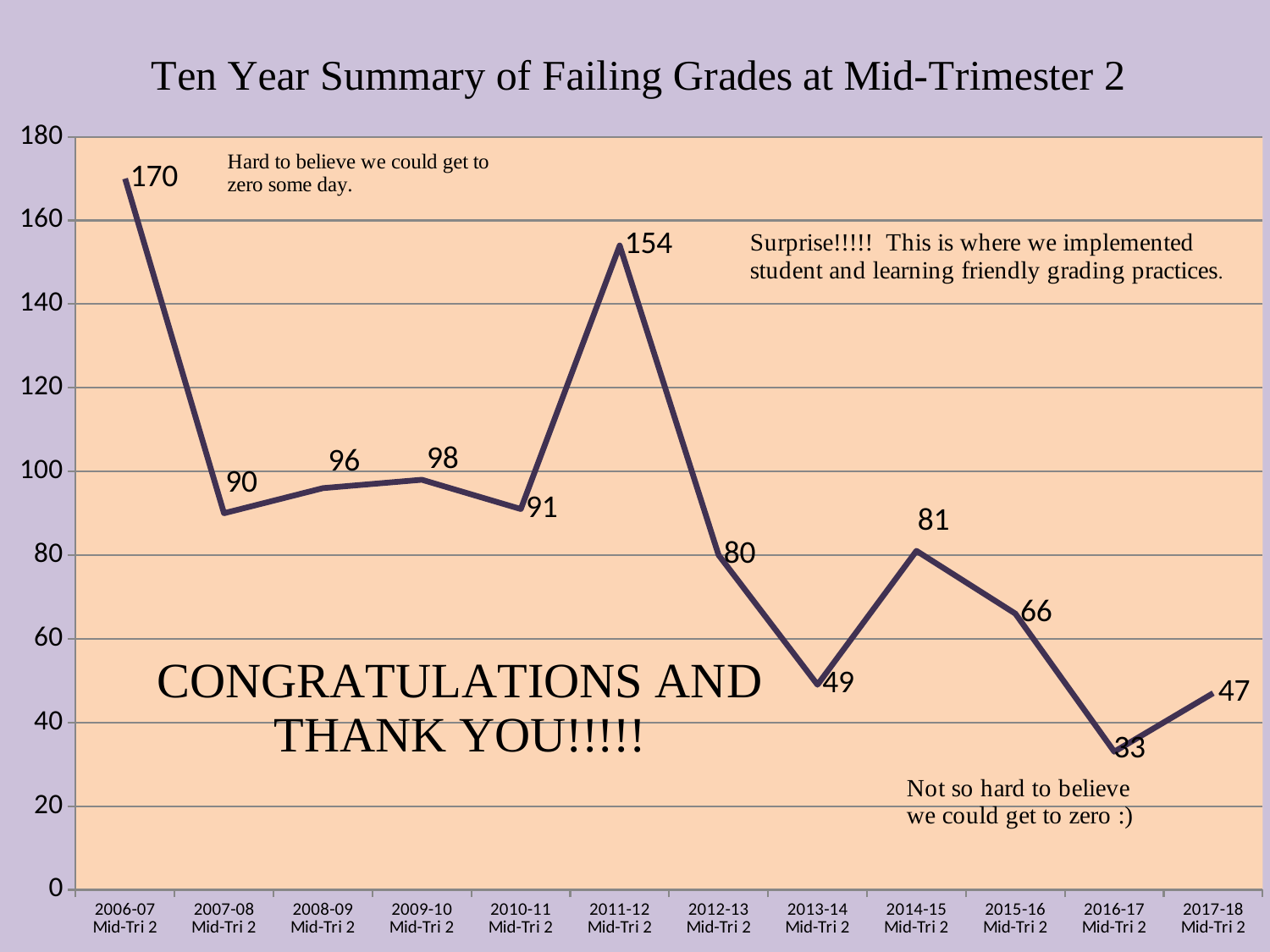
What is the value for 2006-07 Mid-Tri 2? 170 What is the difference between the values for 2006-07 Mid-Tri 2 and 2016-17 Mid-Tri 2? 137 How many data points are plotted on the chart? 12 What is the difference between the values for 2012-13 Mid-Tri 2 and 2013-14 Mid-Tri 2? 31 Do the values generally rise or fall from 2011-12 Mid-Tri 2 to 2016-17 Mid-Tri 2? Fall What is the title of the chart? Ten Year Summary of Failing Grades at Mid-Trimester 2 Which is larger, the value for 2014-15 Mid-Tri 2 or the value for 2015-16 Mid-Tri 2? 2014-15 Mid-Tri 2 What is the value for 2011-12 Mid-Tri 2? 154 What kind of chart is shown on the slide? Line chart Which year has the highest number of failing grades? 2006-07 Mid-Tri 2 What is the value for 2017-18 Mid-Tri 2? 47 Which year has the lowest number of failing grades? 2016-17 Mid-Tri 2